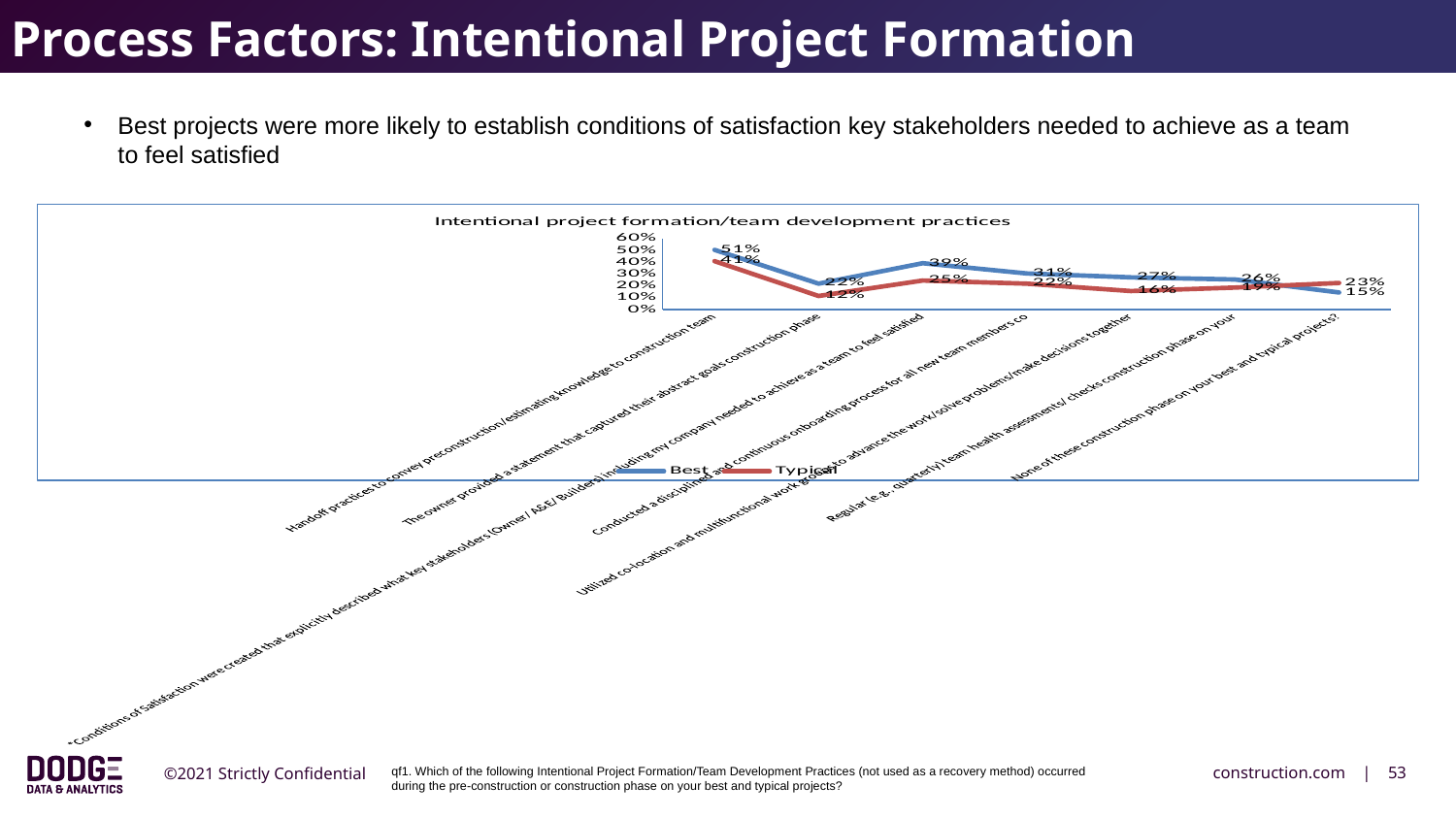
What is the Best value for the last category, 'None of these'? 15% What is the difference between the Best and Typical values for the first category (Handoff practices)? 10 percentage points What is the lowest value in the Typical series? 12% Does the Best series rise or fall from the first category to the second category? Fall What is the Typical value for the first category, 'Handoff practices to convey preconstruction/estimating knowledge to construction team'? 41% What type of chart is shown on the slide? Line chart What is the Best value for the first category, 'Handoff practices to convey preconstruction/estimating knowledge to construction team'? 51% What is the highest value in the Best series? 51% For the last category, 'None of these', which series has the larger value, Best or Typical? Typical How many series does the chart legend list? 2 How many practice categories are plotted along the x axis? 7 Which two series are shown in the chart legend? Best and Typical